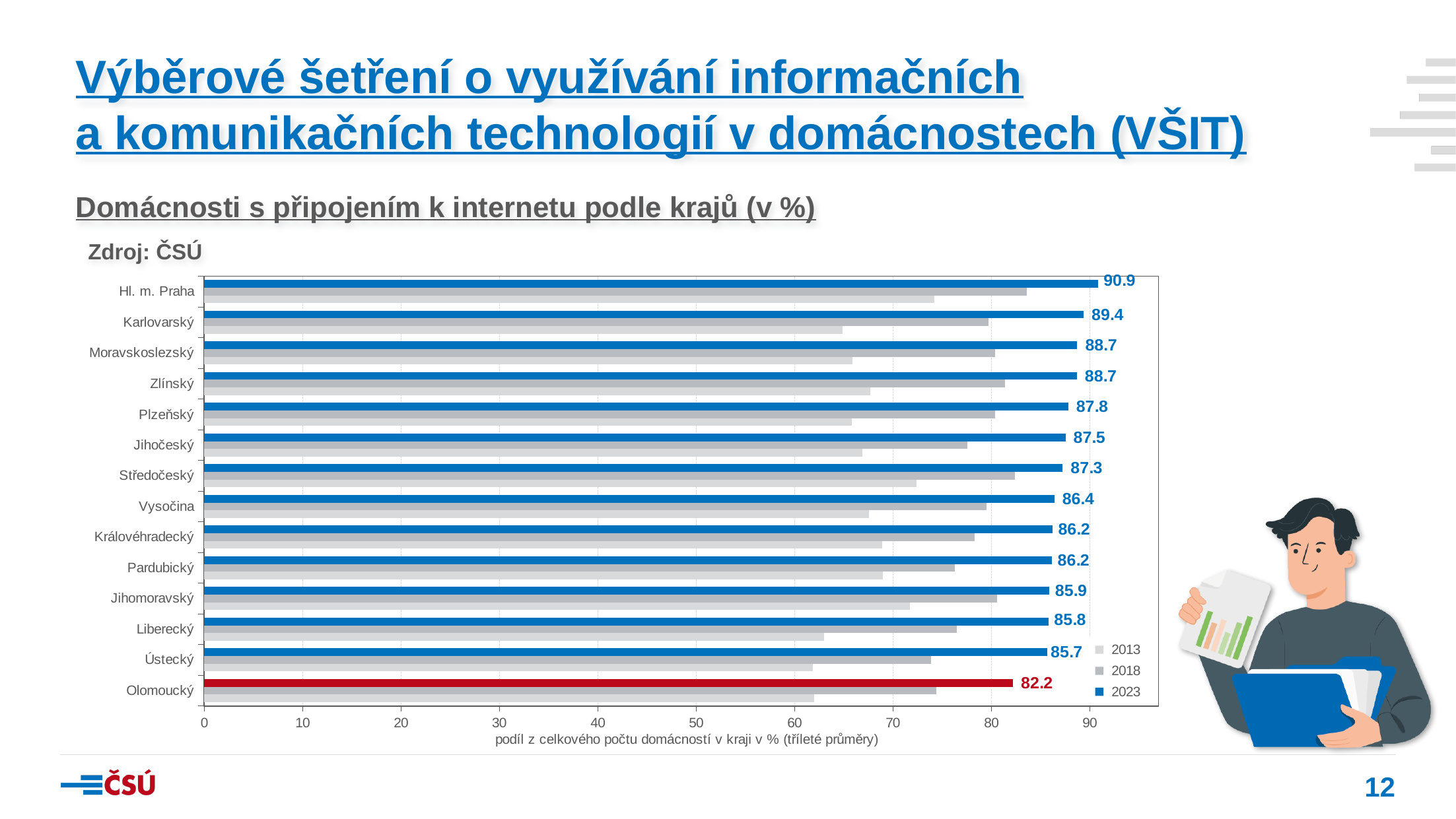
How many regions are shown on the chart? 14 How many series does the legend list? 3 What kind of chart is shown on the slide? bar chart What is the 2023 value for Olomoucký? 82.2 What is the 2023 value for Hl. m. Praha? 90.9 Which region has the highest 2023 value? Hl. m. Praha What is the 2023 value for Vysočina? 86.4 What is the difference between the 2023 values for Hl. m. Praha and Olomoucký? 8.7 Which has the larger 2023 value, Karlovarský or Ústecký? Karlovarský Is the 2013 value for Karlovarský greater or less than 70? less Is the 2018 value for Hl. m. Praha greater or less than 80? greater Which region has the lowest 2023 value? Olomoucký